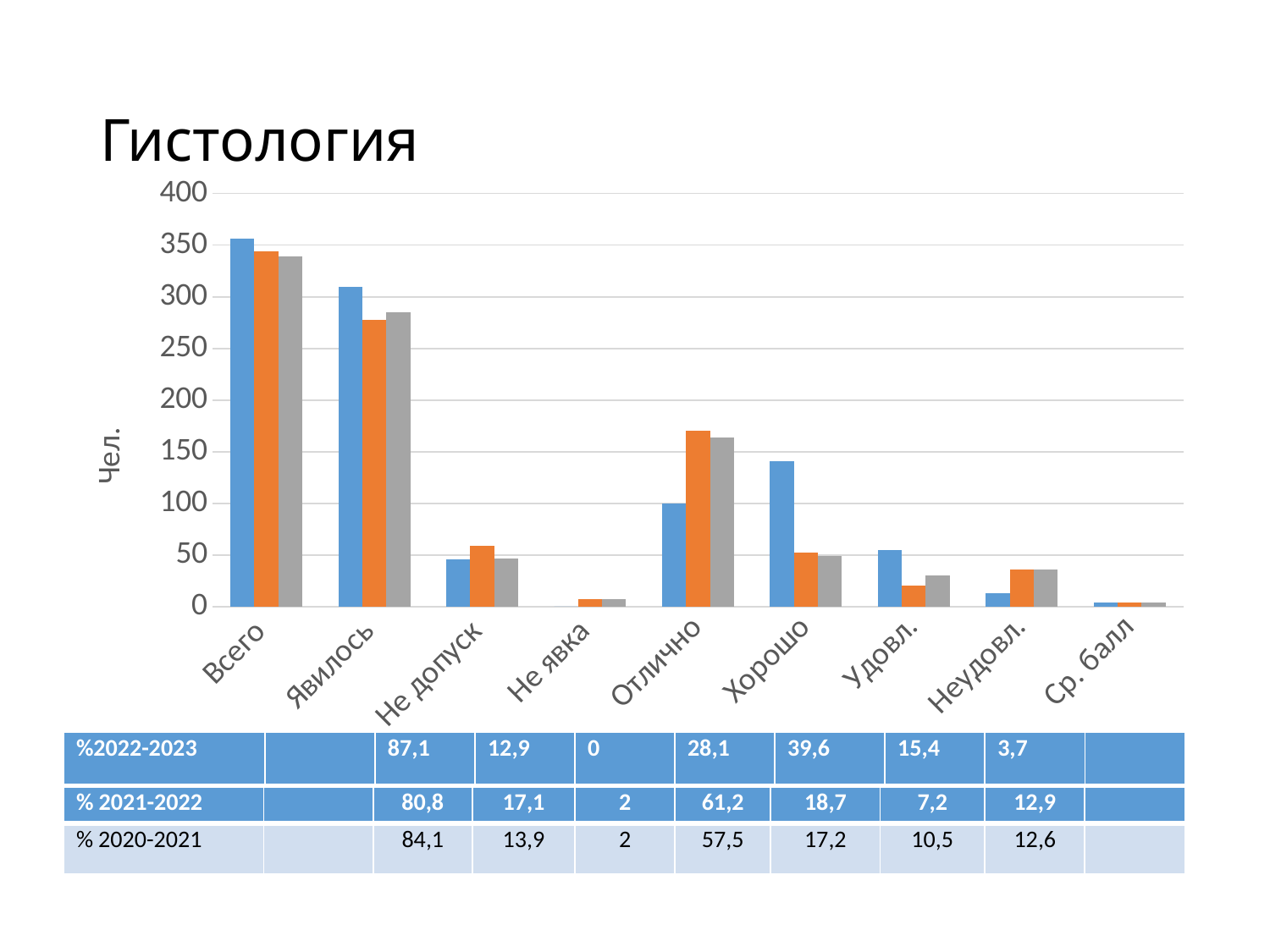
Is the orange bar for Явилось greater or less than 300? less Is the blue bar for Всего greater or less than 300? greater How many categories are shown along the x axis of the chart? 9 For the category Хорошо, which bar is taller, the blue one or the orange one? blue What is the label on the vertical axis of the chart? Чел. Is the blue bar for Хорошо greater or less than 100? greater Which category has the tallest bars in the chart? Всего What is the title of the slide above the chart? Гистология For the category Отлично, which bar is taller, the blue one or the orange one? orange What kind of chart is shown on the slide? bar chart